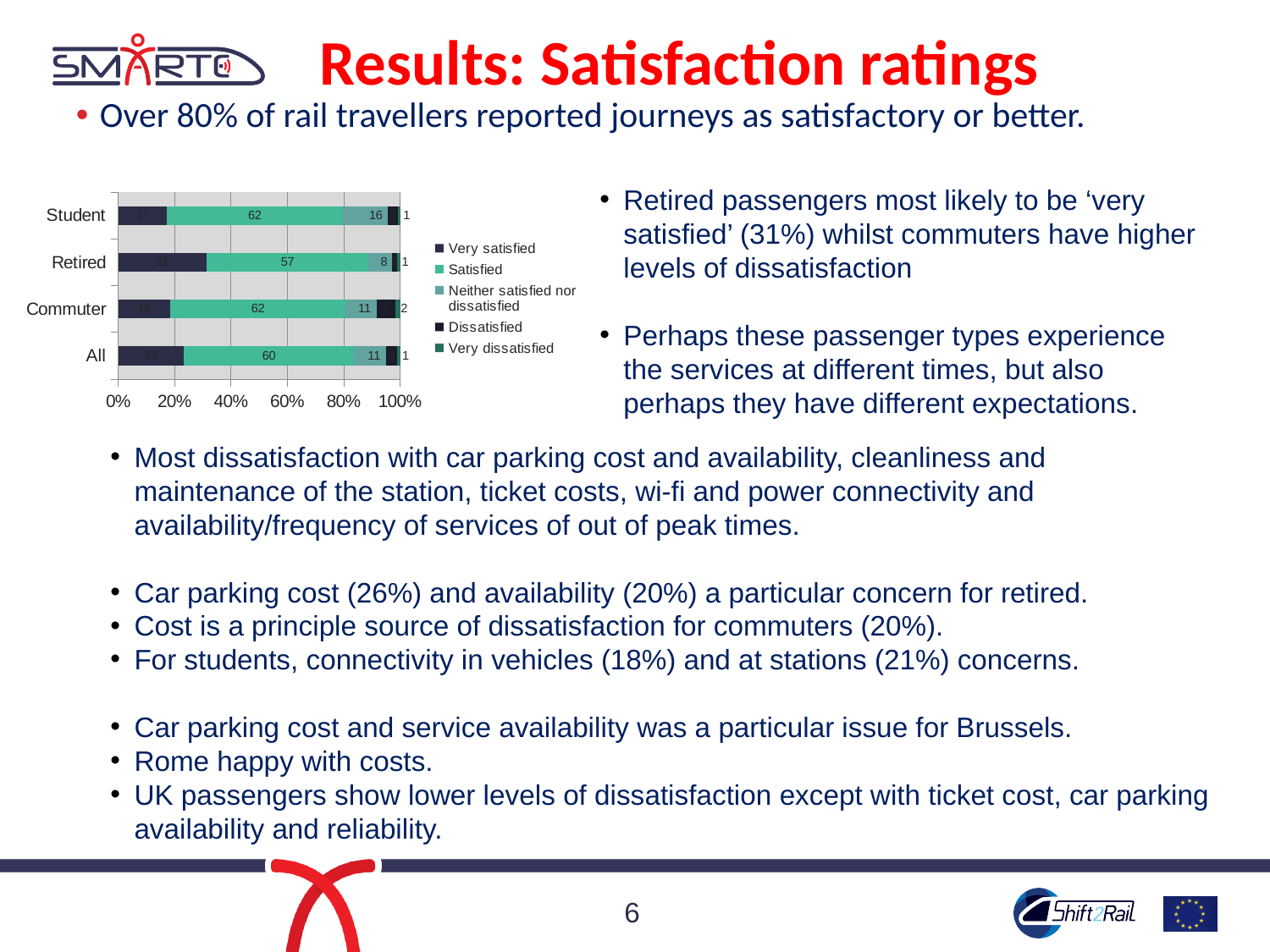
What is the 'Neither satisfied nor dissatisfied' value for Student passengers? 16 Which passenger category has the lowest 'Satisfied' value? Retired How many passenger categories are shown on the chart? 4 What is the 'Satisfied' value for Student passengers? 62 Which passenger category has the highest 'Very satisfied' value? Retired What is the difference between the 'Very satisfied' values for Retired and Student passengers? 14 What type of chart is shown on the slide? Stacked bar chart Which series is shown in the green colour in the chart legend? Satisfied What is the 'Very dissatisfied' value for Commuter passengers? 2 What is the 'Very satisfied' value for Retired passengers? 31 How many series does the chart legend list? 5 Which is larger, the 'Very satisfied' value for All passengers or for Commuter passengers? All